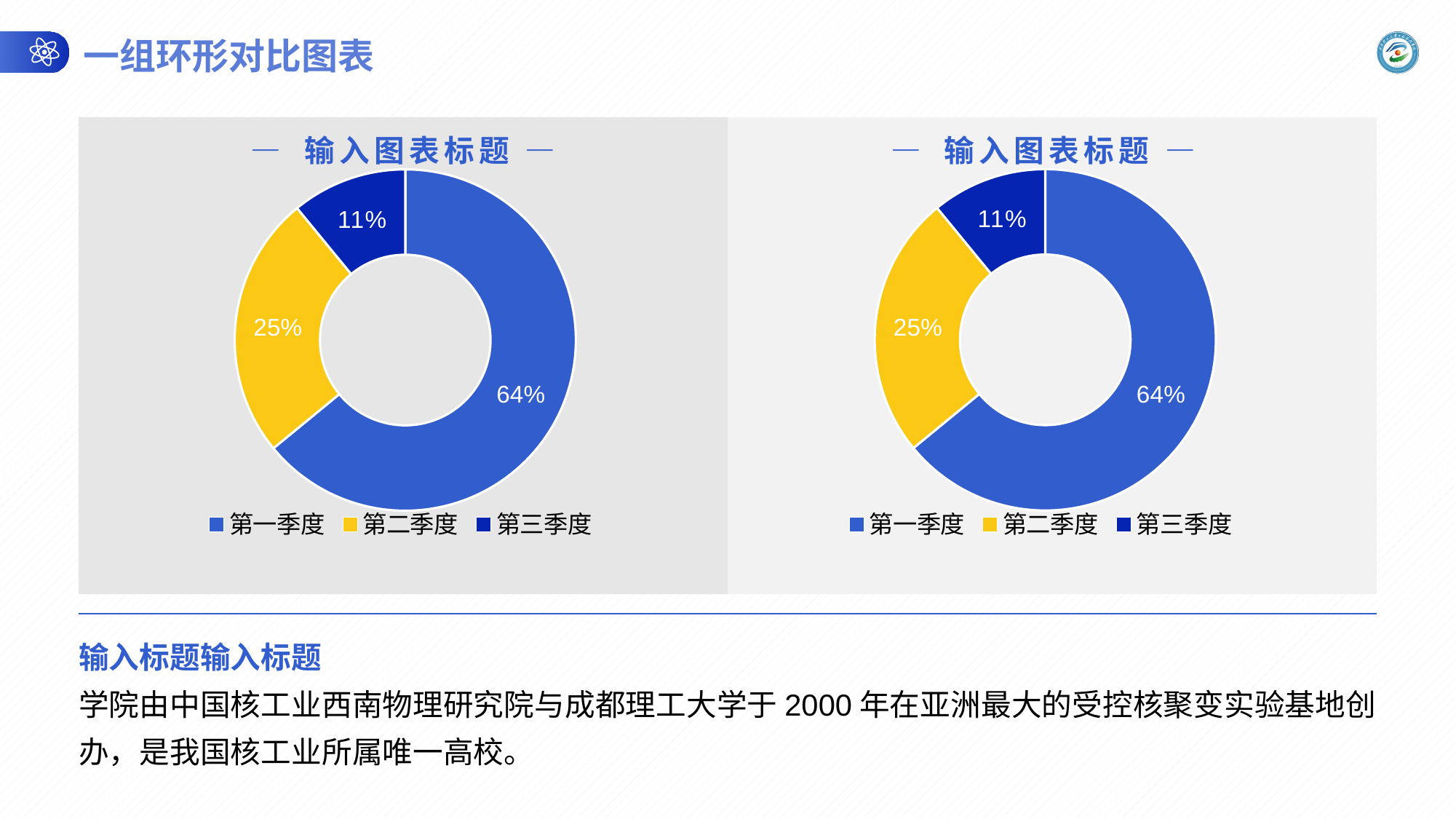
In the right chart, what colour is the 第二季度 slice? Yellow How many categories does the left chart show? 3 In the left chart, what is the difference between the values for 第一季度 and 第二季度? 39% In the right chart, what is the value for 第二季度? 25% How many entries does the legend of the right chart list? 3 In the left chart, which category has the smallest share? 第三季度 In the right chart, what is the difference between the values for 第二季度 and 第三季度? 14% What kind of chart is the left chart? Doughnut (pie) chart In the right chart, which is larger, 第二季度 or 第三季度? 第二季度 In the left chart, what is the value for 第一季度? 64% In the right chart, which category has the largest share? 第一季度 In the left chart, what is the value for 第三季度? 11%